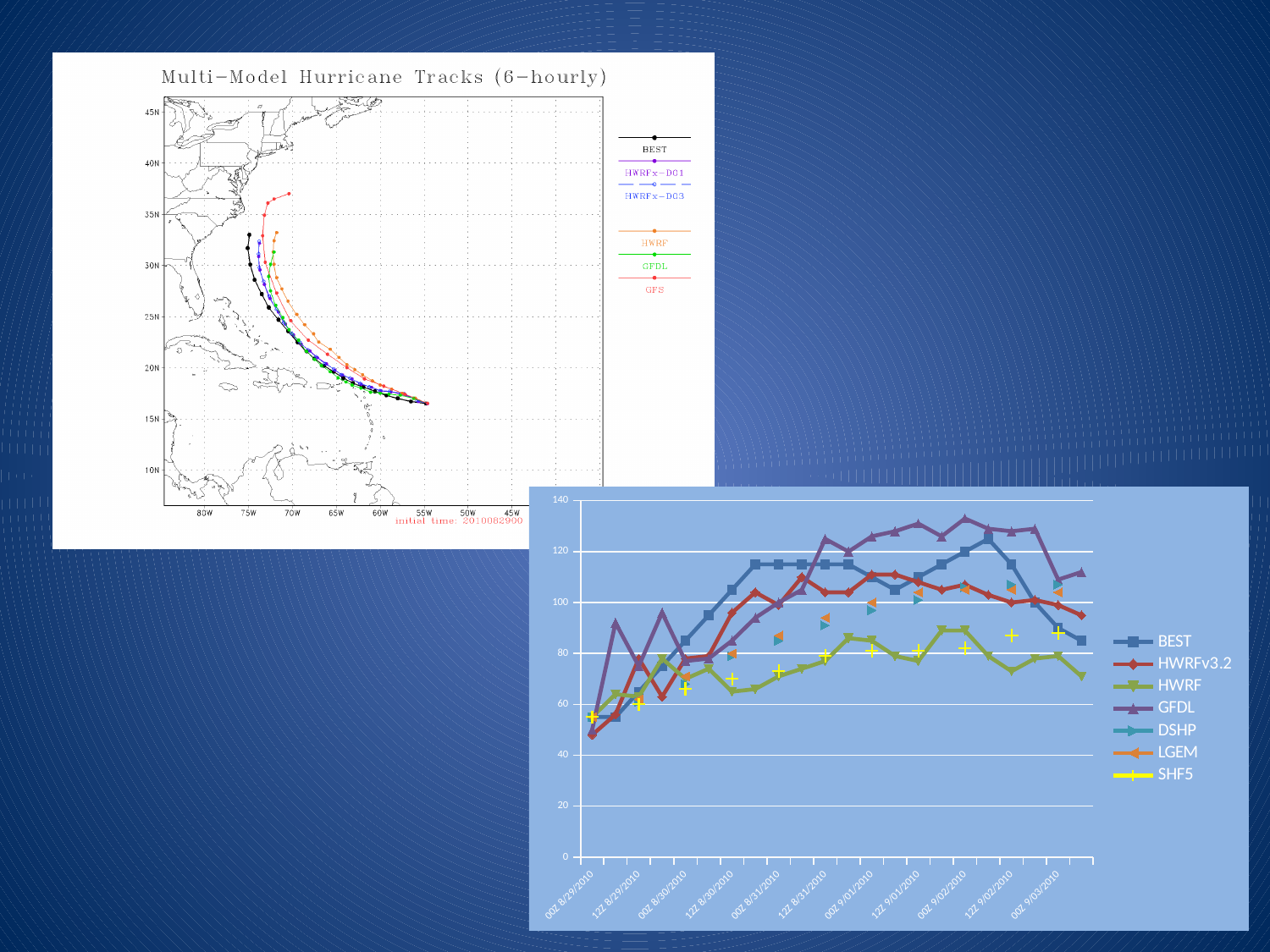
In the bottom-right line chart, is the value for HWRF at 00Z 9/03/2010 greater or less than 100? less In the Multi-Model Hurricane Tracks chart, what initial time is printed below the map? 2010082900 What is the title of the chart on the top left of the slide? Multi-Model Hurricane Tracks (6-hourly) In the bottom-right line chart, how many date labels are shown along the x axis? 11 In the bottom-right line chart, at 00Z 9/03/2010, which is larger: the value for GFDL or the value for HWRF? GFDL In the bottom-right line chart, how many series does the legend list? 7 In the bottom-right line chart, does the BEST series rise or fall between 00Z 8/29/2010 and 12Z 8/30/2010? rise In the bottom-right line chart, is the peak value of GFDL greater or less than 120? greater In the bottom-right line chart, which series reaches the highest value on the chart? GFDL In the bottom-right line chart, is the value for BEST at 00Z 8/29/2010 greater or less than 60? less In the Multi-Model Hurricane Tracks chart, how many entries does the legend list? 6 What kind of chart is the chart on the bottom right of the slide? line chart